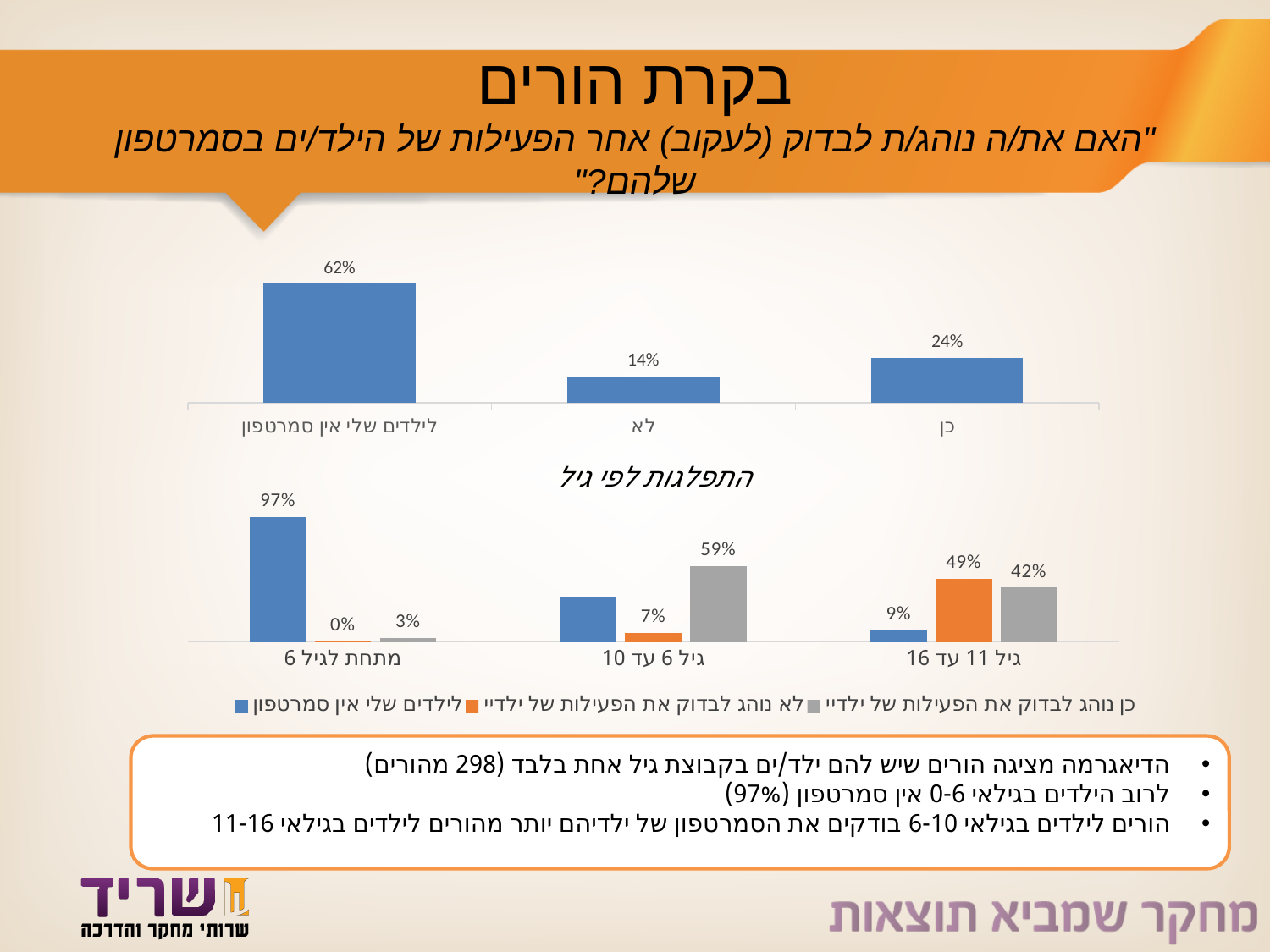
In the top chart, what is the value for "לא"? 14% What is the title of the bottom chart on the slide? התפלגות לפי גיל In the bottom chart (התפלגות לפי גיל), is the gray bar larger for "גיל 6 עד 10" or for "גיל 11 עד 16"? גיל 6 עד 10 In the top chart, what is the difference between the value for "לילדים שלי אין סמרטפון" and the value for "כן"? 38 percentage points In the top chart, what is the value for "כן"? 24% How many categories are shown in the top chart? 3 In the bottom chart (התפלגות לפי גיל), what is the value of the blue bar for "מתחת לגיל 6"? 97% In the bottom chart (התפלגות לפי גיל), how many series does the legend list? 3 In the bottom chart (התפלגות לפי גיל), what is the value of the orange bar for "גיל 11 עד 16"? 49% What kind of chart is the top chart on the slide? bar chart In the top chart, which category has the highest value? לילדים שלי אין סמרטפון In the bottom chart (התפלגות לפי גיל), what is the value of the gray bar for "גיל 6 עד 10"? 59%